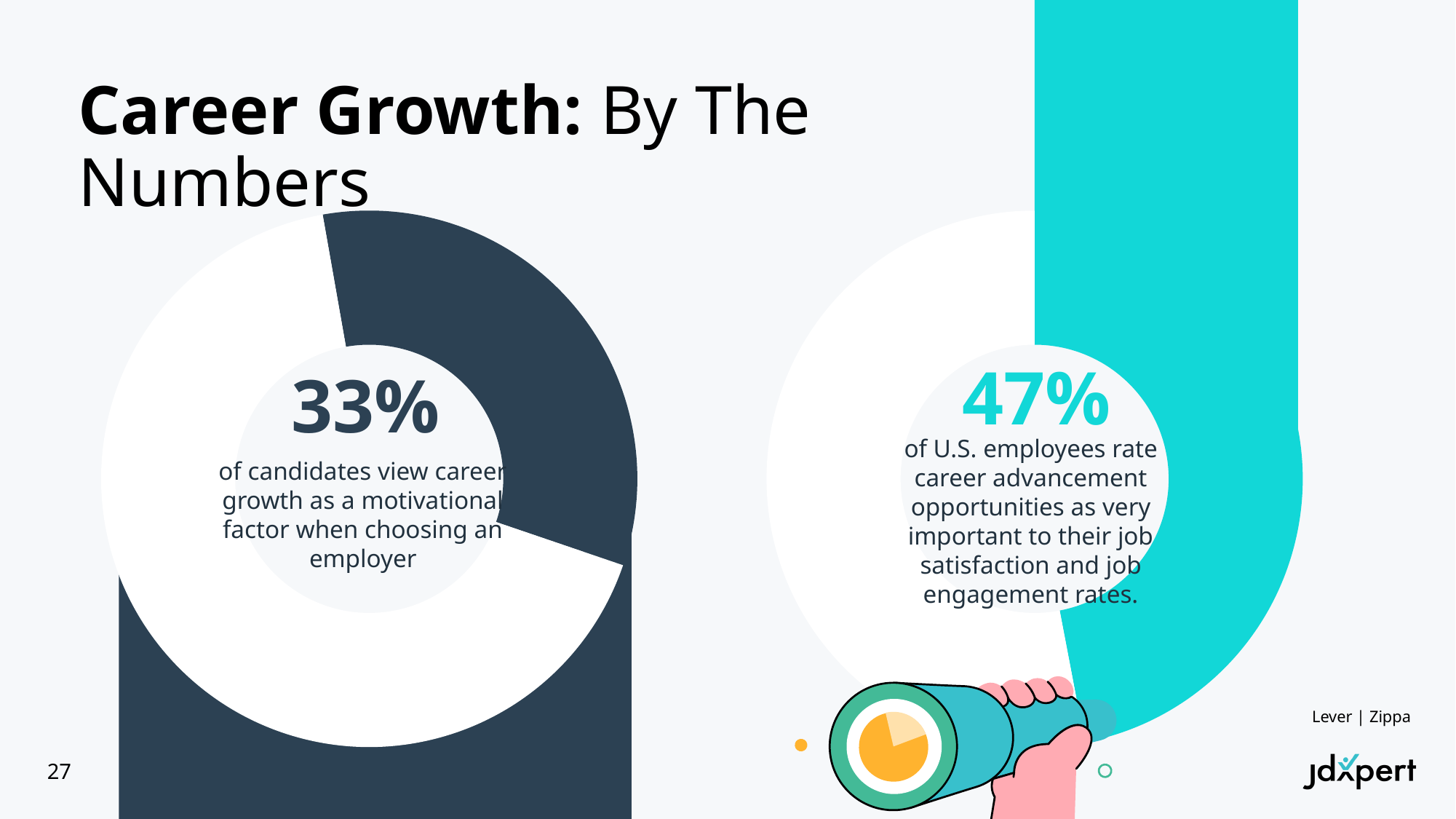
On the right chart, what percentage of U.S. employees rate career advancement opportunities as very important to their job satisfaction and job engagement rates? 47% What kind of chart is used on the left side of the slide? Donut (pie) chart What share of the left donut chart is filled by the dark segment? 33% On the left chart, is the highlighted value greater or less than 50%? less What is the difference in percentage points between the right chart's value and the left chart's value? 14 percentage points What share of the right donut chart is filled by the teal segment? 47% What colour is the filled segment of the right chart? Teal On the left chart, what percentage of candidates view career growth as a motivational factor when choosing an employer? 33% Which chart shows the larger percentage, the left chart (33%) or the right chart (47%)? The right chart (47%) On the right chart, is the highlighted value greater or less than 25%? greater What is the title of the slide containing the two charts? Career Growth: By The Numbers How many donut charts are shown on the slide? 2